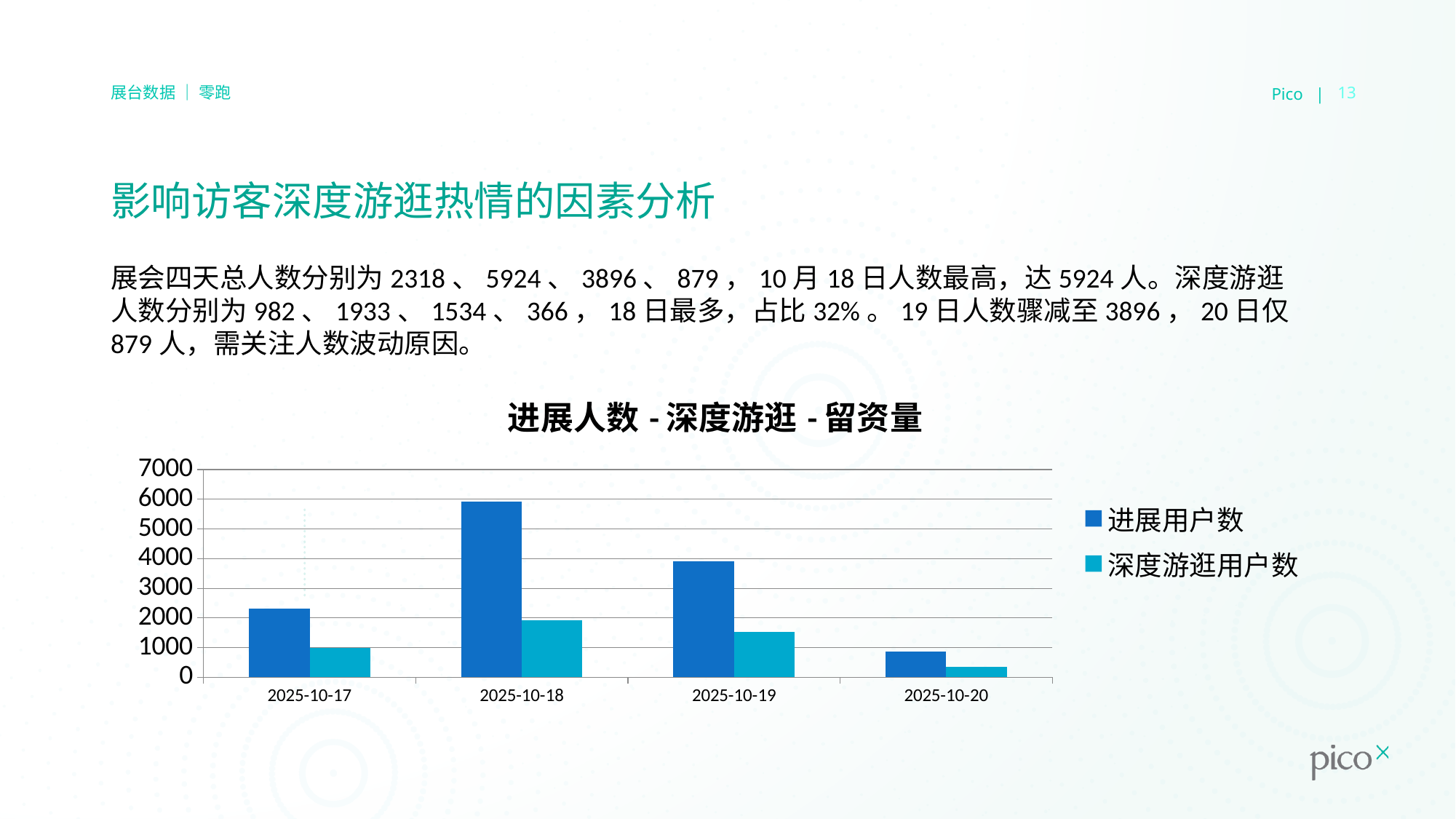
How many series does the legend list? 2 Is the value of 进展用户数 for 2025-10-20 greater or less than 1000? less Which date has the larger 进展用户数, 2025-10-17 or 2025-10-19? 2025-10-19 Is the value of 深度游逛用户数 for 2025-10-17 greater or less than 2000? less How many dates are shown on the x axis of the chart? 4 From 2025-10-18 to 2025-10-20, does 进展用户数 rise or fall? fall On which date is 进展用户数 highest? 2025-10-18 On which date is 深度游逛用户数 highest? 2025-10-18 Is the value of 进展用户数 for 2025-10-18 greater or less than 5000? greater What is the title of the chart? 进展人数 - 深度游逛 - 留资量 What kind of chart is shown on the slide? bar chart On which date is 进展用户数 lowest? 2025-10-20